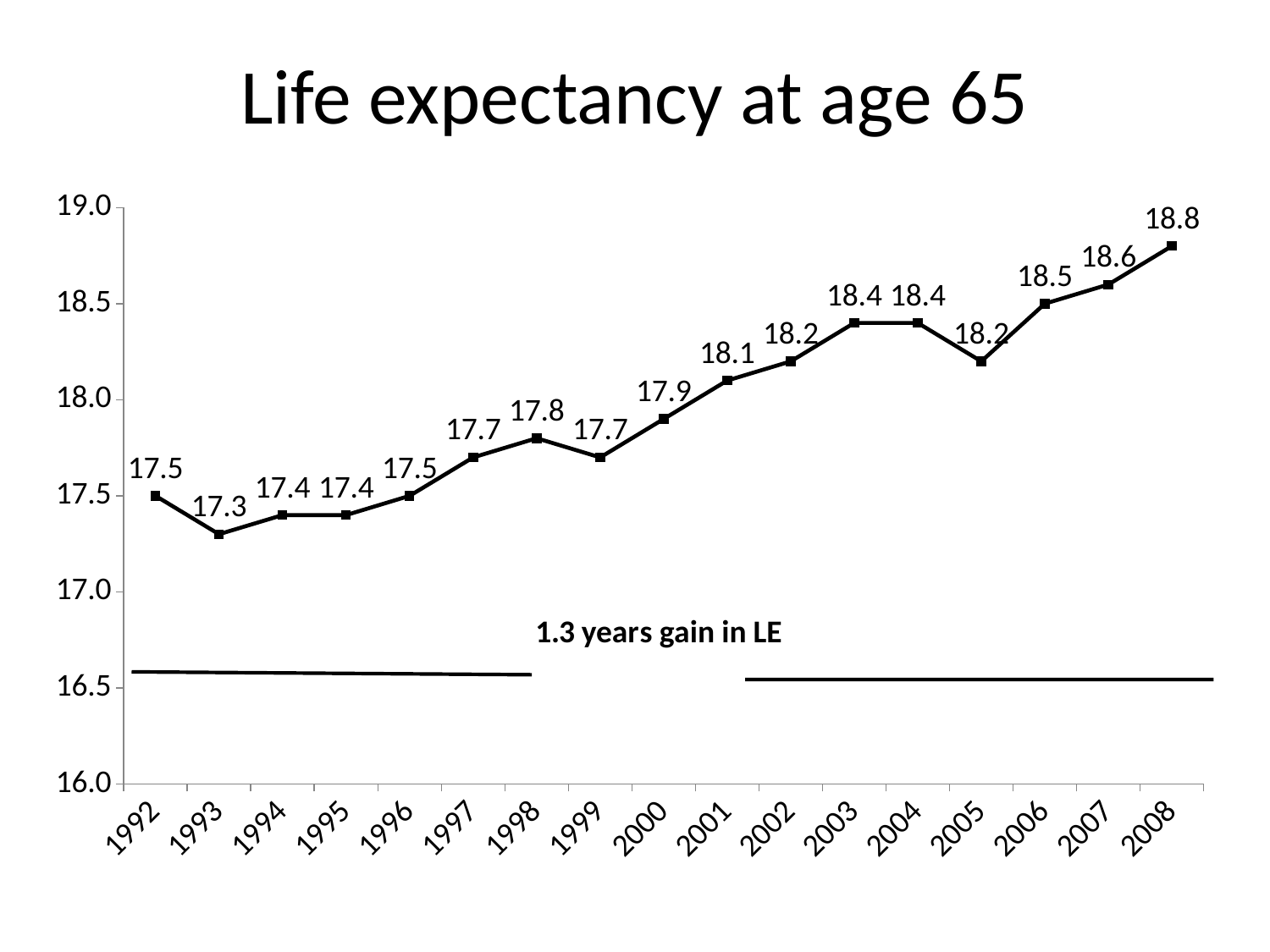
What is the life expectancy at age 65 shown for 1992? 17.5 Which year has the lowest life expectancy at age 65? 1993 What value is plotted for 1999? 17.7 Which year has the larger value, 2004 or 2005? 2004 How many years are plotted on the x axis? 17 Do the values generally rise or fall from 1992 to 2008? rise What is the title of the chart? Life expectancy at age 65 What is the life expectancy at age 65 shown for 2008? 18.8 What kind of chart is shown on the slide? line chart Which year has the highest life expectancy at age 65? 2008 What is the difference between the values for 2008 and 1992? 1.3 What value is plotted for 2005? 18.2